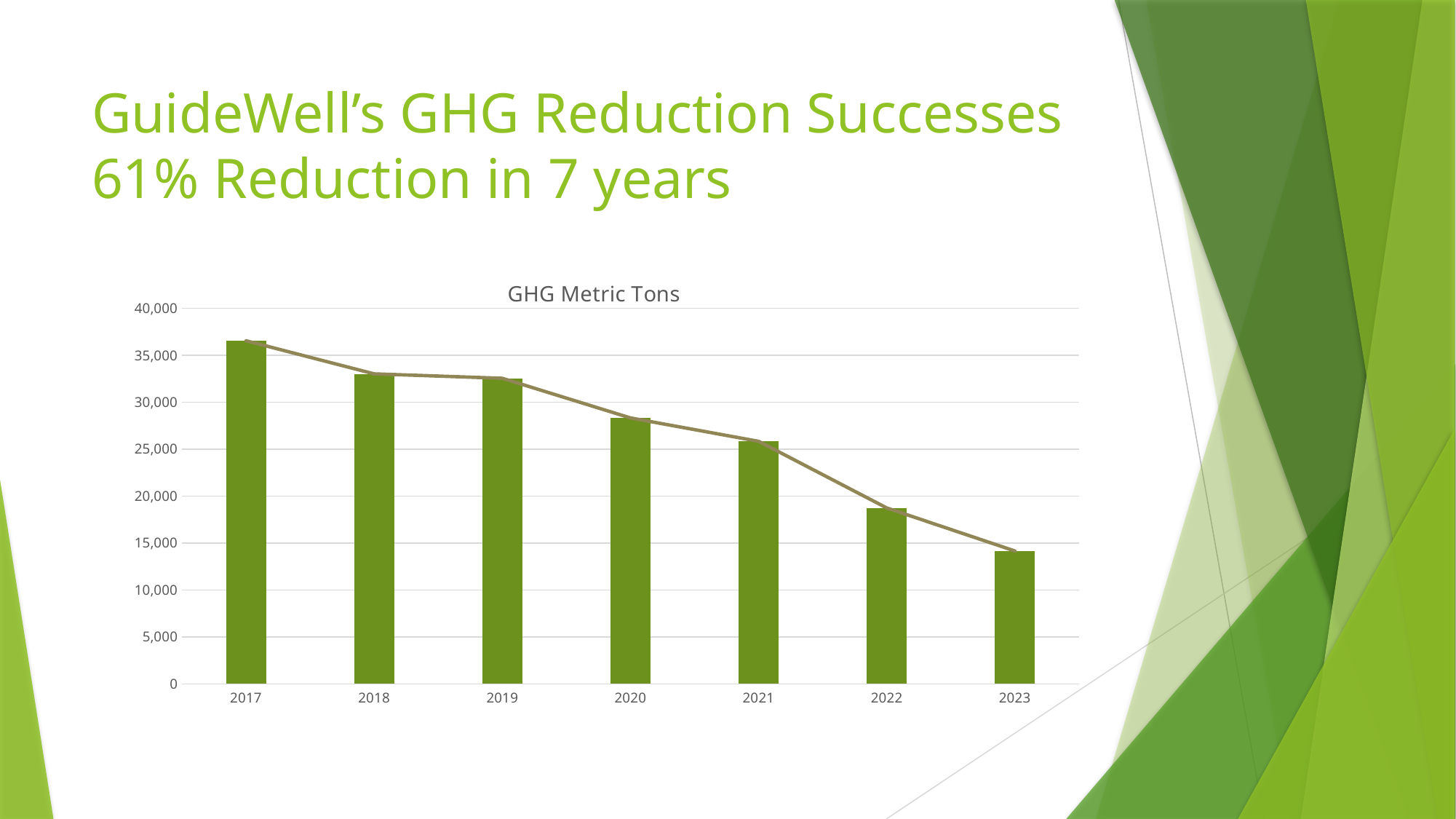
Is the value for 2023 greater or less than 15,000? less Is the value for 2017 greater or less than 35,000? greater How many years are plotted on the x axis of the chart? 7 Is the value for 2020 greater or less than 30,000? less What kind of chart is shown on the slide? combination bar and line chart Do the GHG Metric Tons values rise or fall from 2017 to 2023? fall What is the title of the chart? GHG Metric Tons Which year has the highest GHG Metric Tons value? 2017 Which year has the lowest GHG Metric Tons value? 2023 Which is larger, the value for 2020 or the value for 2022? 2020